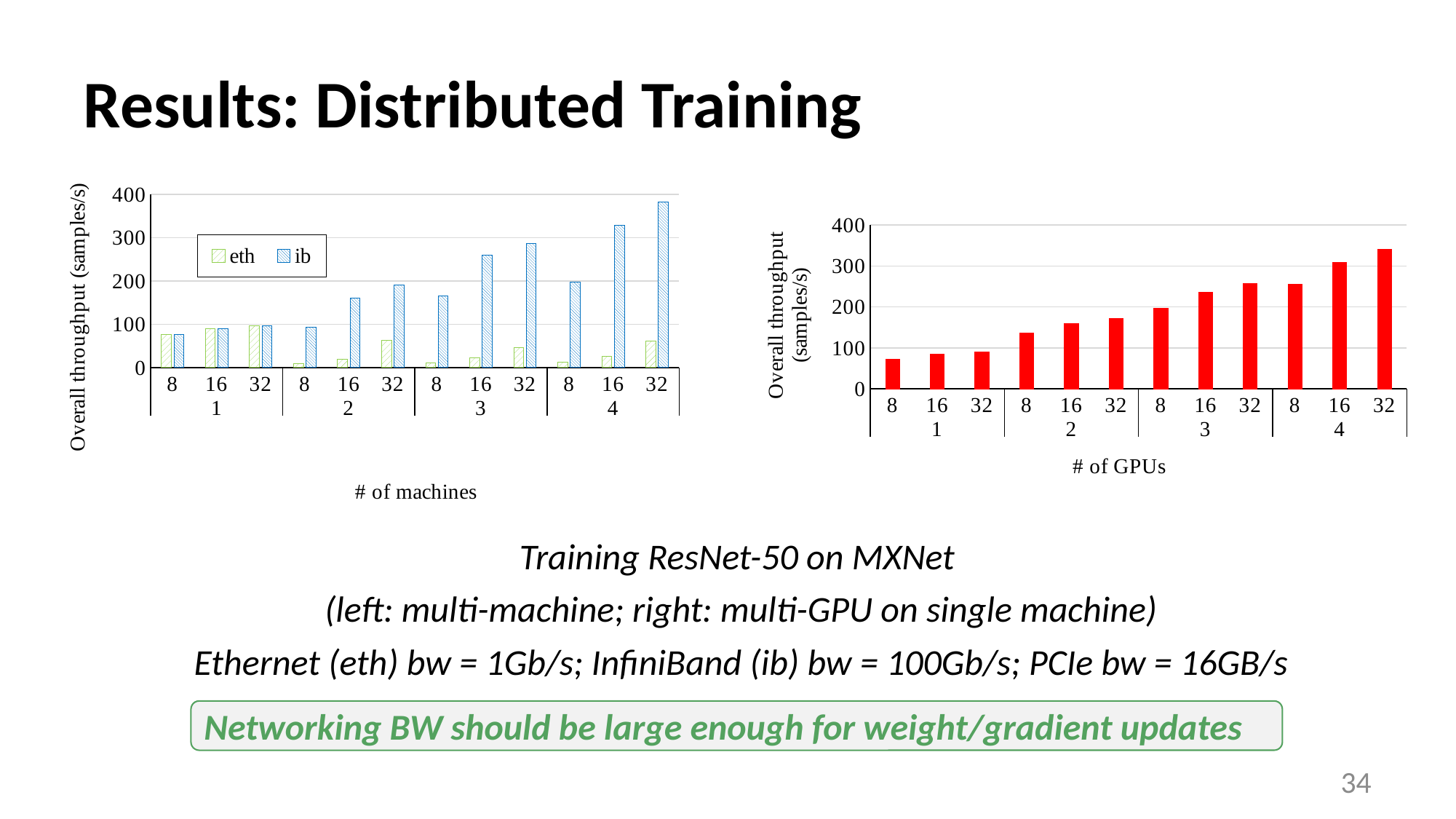
In the right chart, which x-axis position has the lowest bar? 1 GPU, 8 In the left chart, for which x-axis position is the ib bar highest? 4 machines, 32 What kind of chart is the left chart (multi-machine)? bar chart What are the two series named in the legend of the left chart? eth and ib In the left chart, which series has the higher value for 3 machines with 16, eth or ib? ib In the right chart, do the values generally rise or fall from left to right along the x axis? rise In the right chart, which x-axis position has the highest bar? 4 GPUs, 32 In the left chart, is the ib value for 4 machines with 32 greater or less than 300? greater How many bars are plotted in the right chart (multi-GPU)? 12 How many series does the legend of the left chart list? 2 In the left chart, is the eth value for 2 machines with 8 greater or less than 100? less